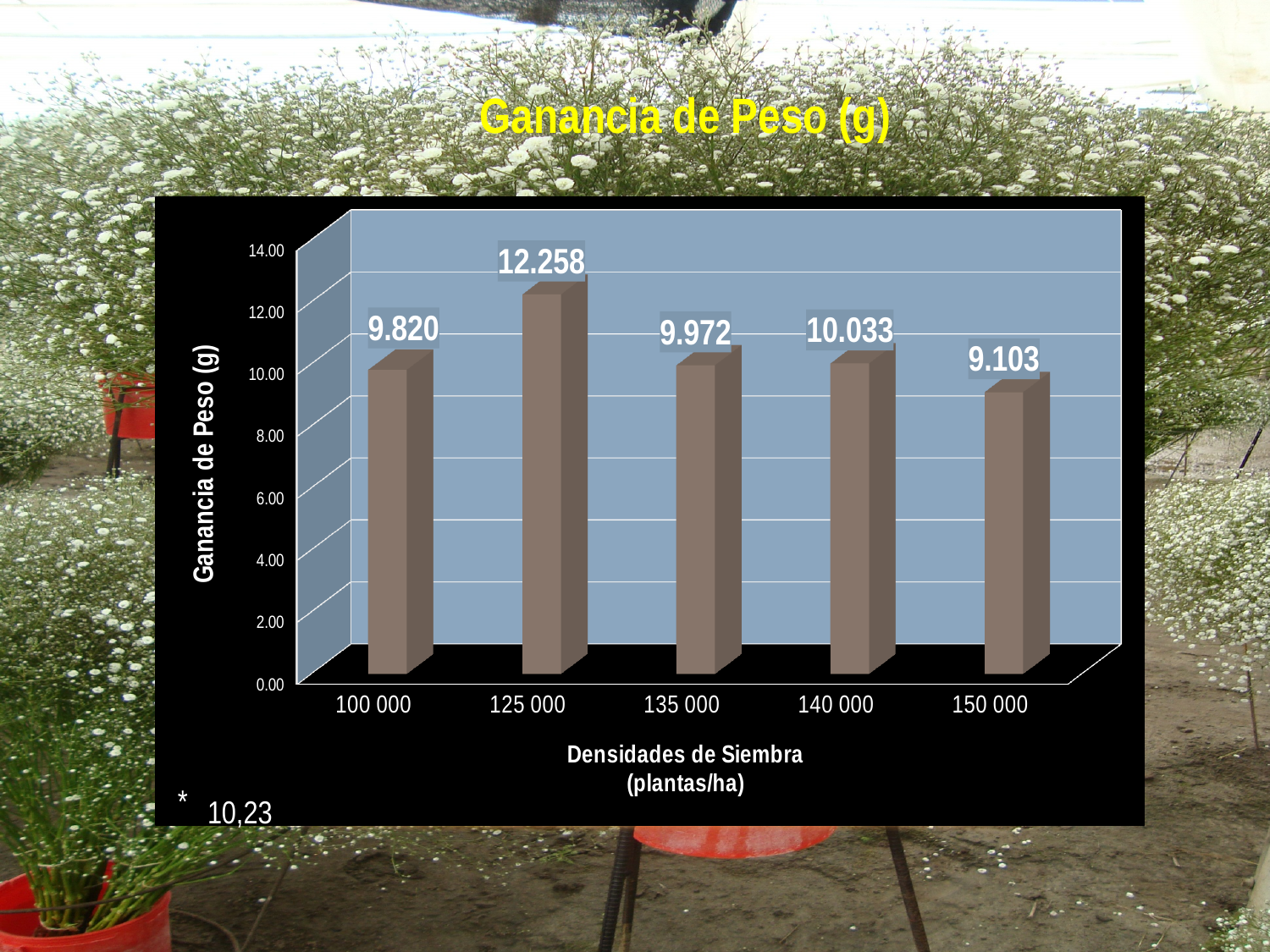
What is the title of the chart? Ganancia de Peso (g) Which sowing density has the highest weight gain? 125 000 What is the difference between the values for 125 000 and 150 000 plantas/ha? 3.155 Which is larger, the value for 140 000 or the value for 150 000 plantas/ha? 140 000 What is the value for the 100 000 plantas/ha density? 9.820 Which sowing density has the lowest weight gain? 150 000 What kind of chart is shown on the slide? bar chart What is the value for the 125 000 plantas/ha density? 12.258 How many sowing densities are shown on the x axis? 5 What is the difference between the values for 125 000 and 100 000 plantas/ha? 2.438 Is the value for 150 000 plantas/ha greater or less than 10.00? less What is the value for the 150 000 plantas/ha density? 9.103